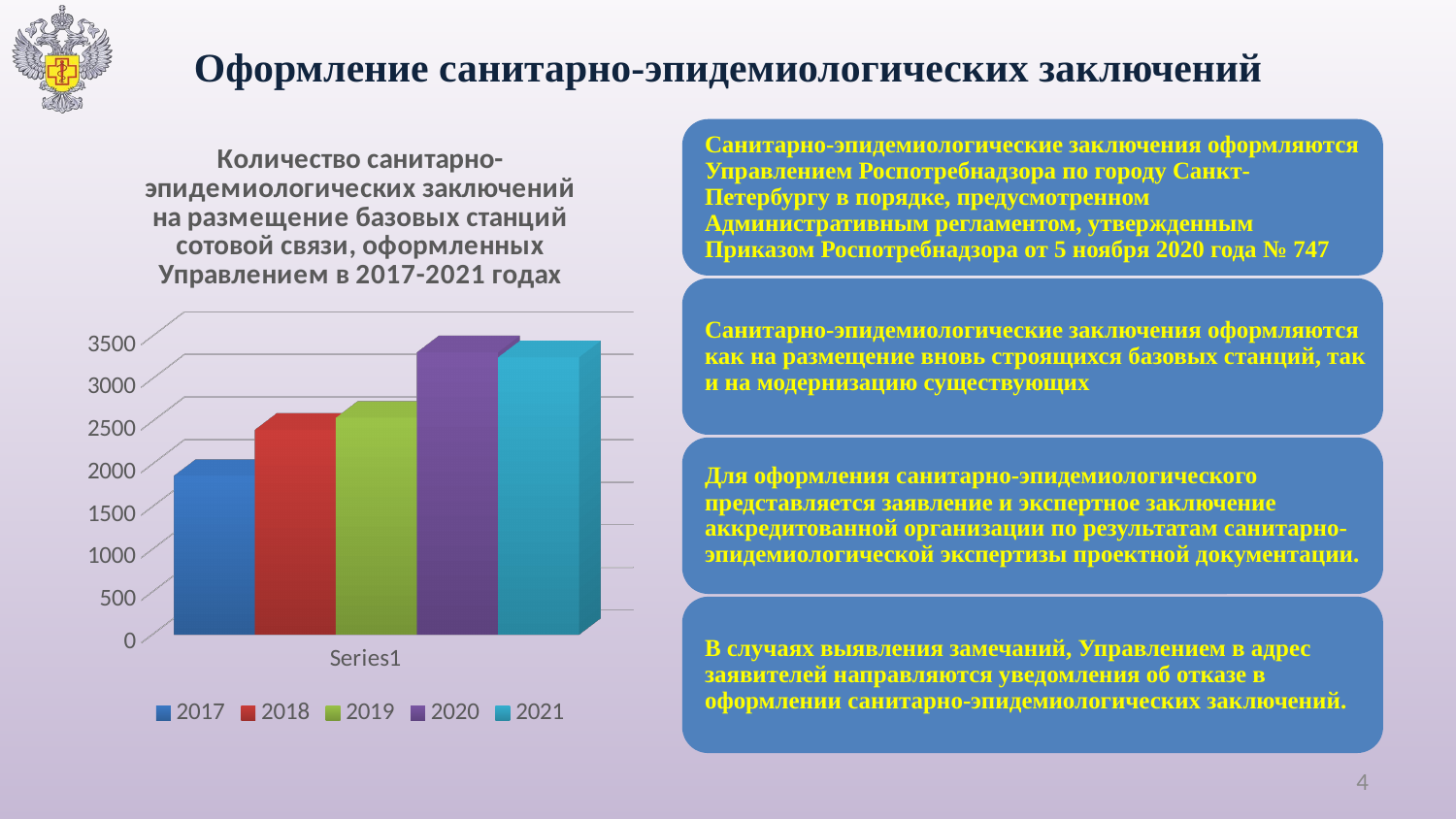
Is the value for 2019 greater or less than 3000? less Which is larger, the value for 2020 or the value for 2021? 2020 Is the value for 2018 greater or less than 2000? greater Which year has the highest bar in the chart? 2020 Is the value for 2021 greater or less than 3000? greater What kind of chart is shown on the slide? bar chart Which is larger, the value for 2017 or the value for 2018? 2018 Which year has the lowest bar in the chart? 2017 How many series does the chart legend list? 5 What is the category label shown on the x axis of the chart? Series1